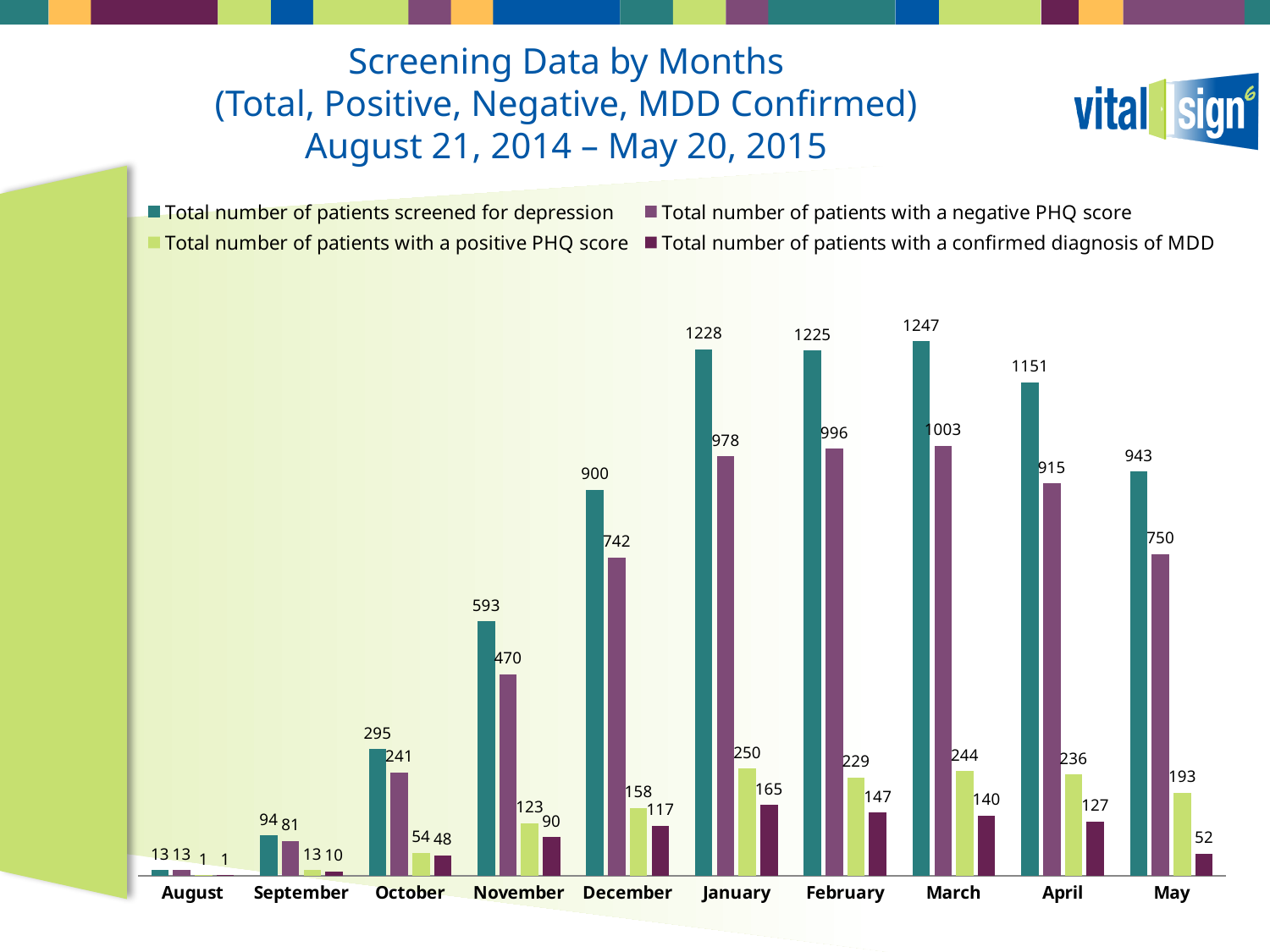
What is the difference between the total number of patients screened for depression in March and in April? 96 What is the total number of patients screened for depression in March? 1247 Which month has more patients with a positive PHQ score, January or February? January Which month has the lowest total number of patients screened for depression? August Which month has the highest total number of patients screened for depression? March How many months are shown on the x axis of the chart? 10 What is the total number of patients with a positive PHQ score in November? 123 What is the difference between the total number of patients screened for depression and the number with a negative PHQ score in January? 250 What kind of chart is shown on the slide? Bar chart What is the total number of patients with a negative PHQ score in December? 742 How many series does the legend list? 4 What is the total number of patients with a confirmed diagnosis of MDD in May? 52